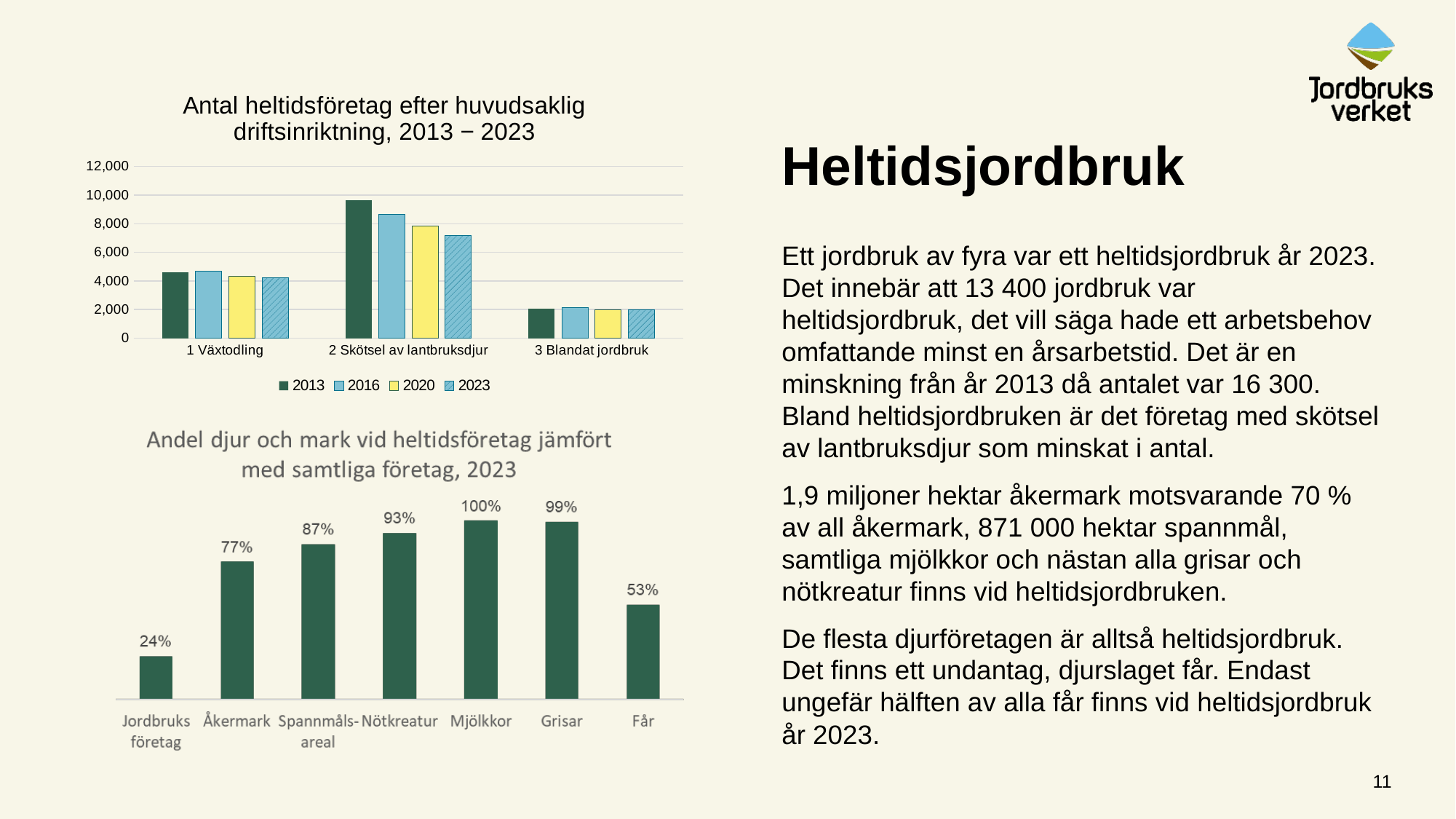
In the top chart, 'Antal heltidsföretag efter huvudsaklig driftsinriktning, 2013 − 2023', do the values for '2 Skötsel av lantbruksdjur' rise or fall from 2013 to 2023? fall In the bottom chart, 'Andel djur och mark vid heltidsföretag jämfört med samtliga företag, 2023', what is the difference between the values for Mjölkkor and Jordbruksföretag? 76 percentage points What kind of chart is the bottom chart, 'Andel djur och mark vid heltidsföretag jämfört med samtliga företag, 2023'? Bar chart In the bottom chart, 'Andel djur och mark vid heltidsföretag jämfört med samtliga företag, 2023', which is larger, the value for Spannmålsareal or the value for Nötkreatur? Nötkreatur In the top chart, 'Antal heltidsföretag efter huvudsaklig driftsinriktning, 2013 − 2023', is the 2013 value for '2 Skötsel av lantbruksdjur' greater or less than 8,000? greater How many categories are shown in the bottom chart, 'Andel djur och mark vid heltidsföretag jämfört med samtliga företag, 2023'? 7 In the bottom chart, 'Andel djur och mark vid heltidsföretag jämfört med samtliga företag, 2023', which category has the lowest value? Jordbruksföretag How many categories are shown on the x axis of the top chart, 'Antal heltidsföretag efter huvudsaklig driftsinriktning, 2013 − 2023'? 3 How many series does the legend list in the top chart, 'Antal heltidsföretag efter huvudsaklig driftsinriktning, 2013 − 2023'? 4 In the bottom chart, 'Andel djur och mark vid heltidsföretag jämfört med samtliga företag, 2023', what is the value for Får? 53% In the bottom chart, 'Andel djur och mark vid heltidsföretag jämfört med samtliga företag, 2023', which category has the highest value? Mjölkkor In the bottom chart, 'Andel djur och mark vid heltidsföretag jämfört med samtliga företag, 2023', what is the value for Åkermark? 77%